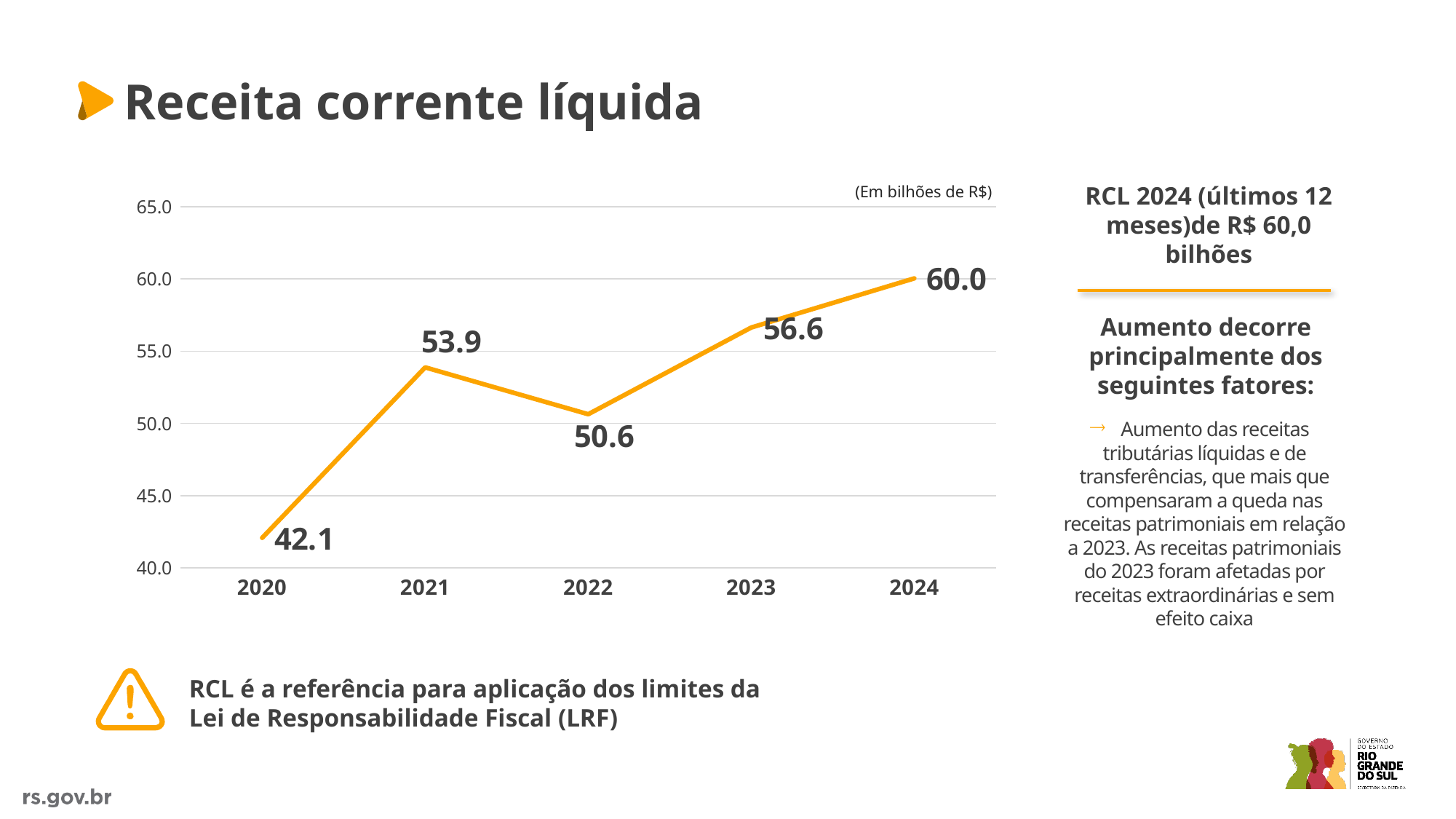
How many years are plotted on the chart? 5 Which year has the highest value? 2024 Which is larger, the value for 2021 or the value for 2022? 2021 What is the difference between the values for 2021 and 2022? 3.3 What kind of chart is shown on the slide? line chart What is the value for 2020? 42.1 Which year has the lowest value? 2020 Is the value for 2023 greater or less than 55.0? greater What unit is stated for the values on the chart? Em bilhões de R$ What is the value for 2022? 50.6 What is the value for 2024? 60.0 What is the difference between the values for 2024 and 2020? 17.9